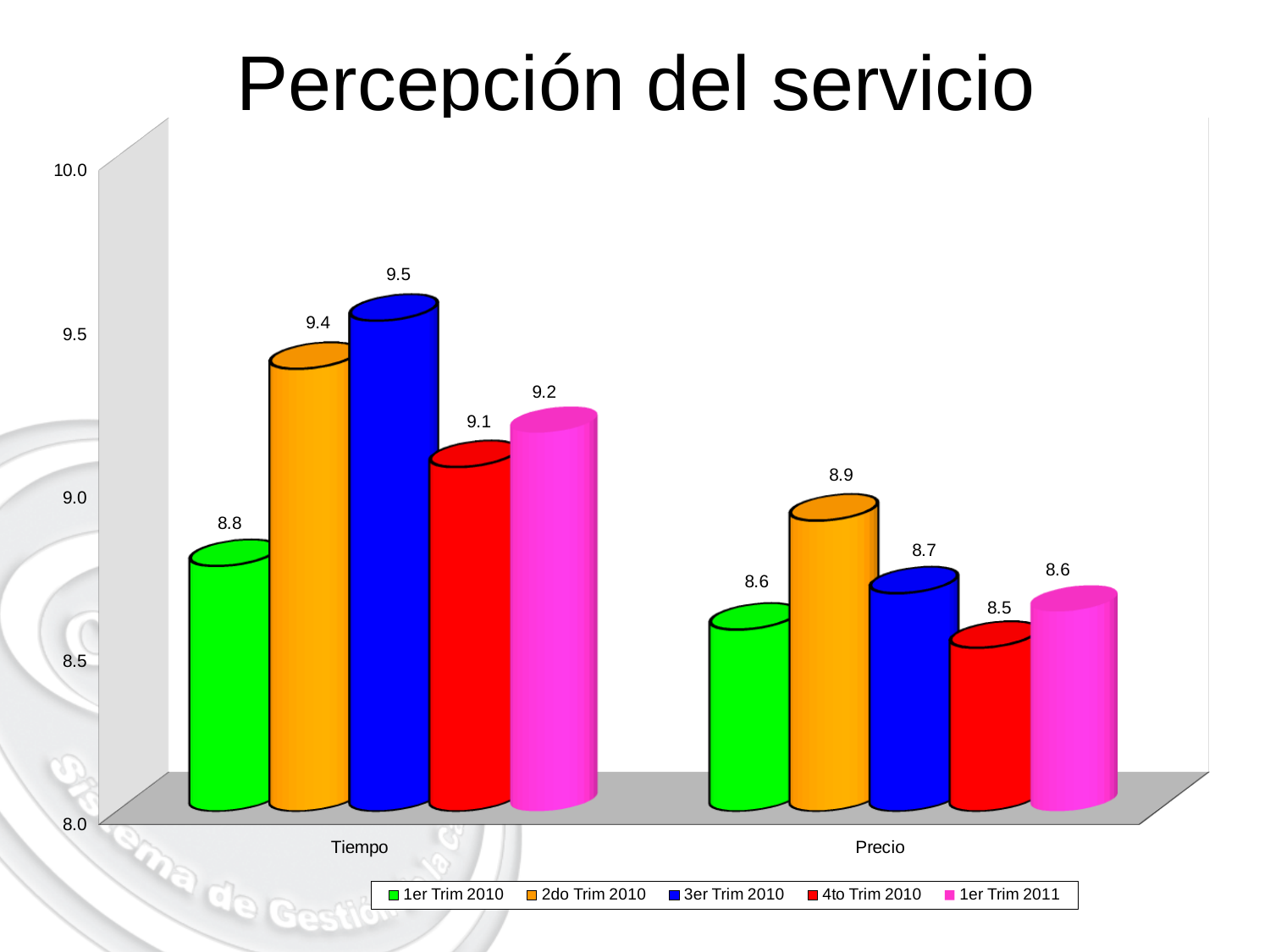
What is the value for 3er Trim 2010 in the Tiempo category? 9.5 What is the title of the chart? Percepción del servicio How many series does the legend list? 5 What is the value for 1er Trim 2011 in the Tiempo category? 9.2 Which is larger: the 1er Trim 2010 value for Tiempo or the 2do Trim 2010 value for Precio? 1er Trim 2010 value for Tiempo What kind of chart is shown on the slide? Bar chart What is the value for 4to Trim 2010 in the Precio category? 8.5 Which series has the highest value in the Tiempo category? 3er Trim 2010 How many categories are shown on the x axis? 2 What is the value for 2do Trim 2010 in the Precio category? 8.9 What is the difference between the 3er Trim 2010 values for Tiempo and Precio? 0.8 Which series has the lowest value in the Precio category? 4to Trim 2010